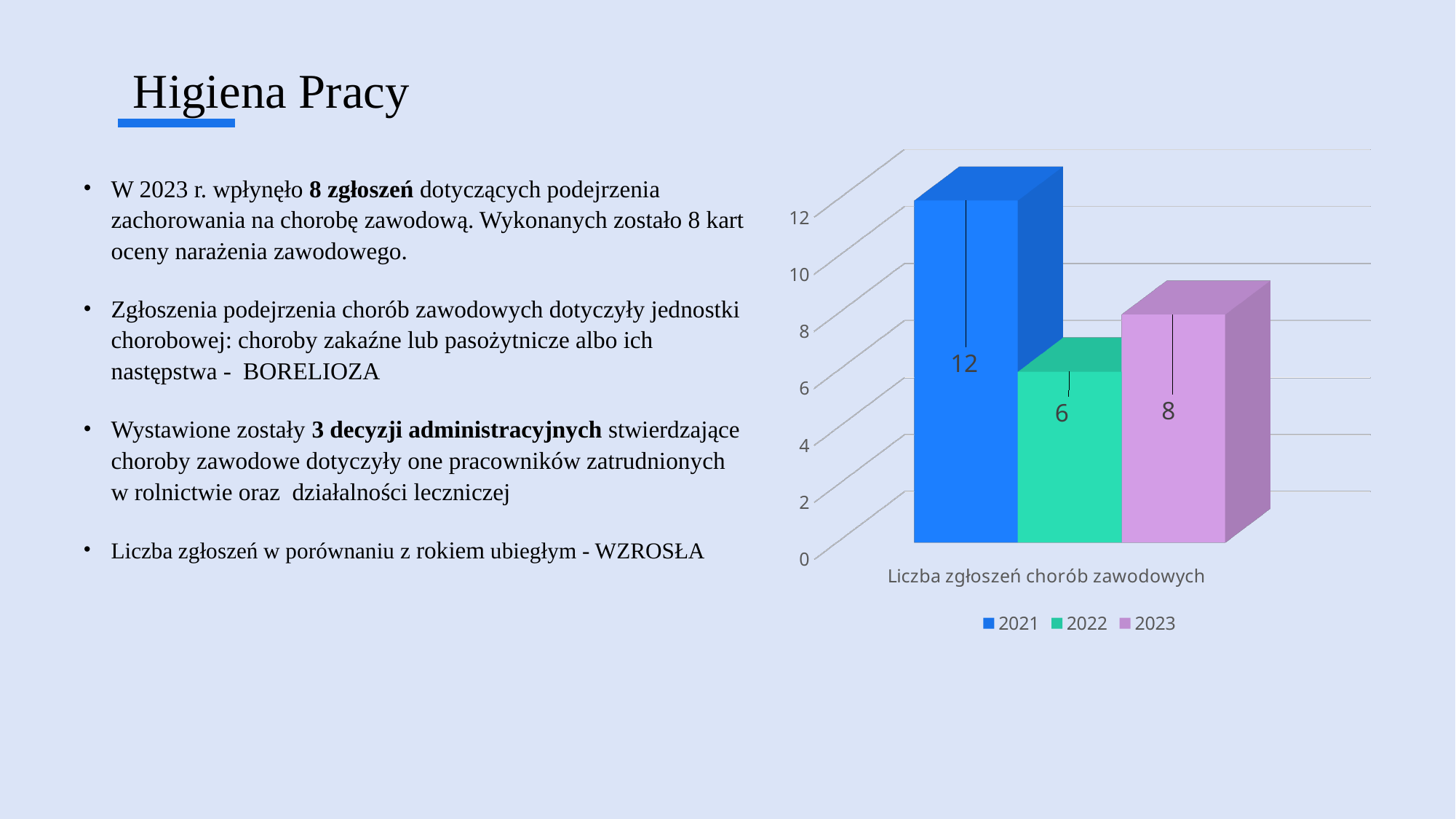
How many series does the legend list? 3 Which year has the highest value in the chart? 2021 What is the value for 2021 in the chart? 12 What kind of chart is shown on the slide? bar chart What is the difference between the values for 2023 and 2022? 2 What is the value for 2023 in the chart? 8 What colour is the bar for 2023? purple What is the difference between the values for 2021 and 2022? 6 What is the category label shown under the bars? Liczba zgłoszeń chorób zawodowych Which is larger, the value for 2022 or the value for 2023? 2023 Which year has the lowest value in the chart? 2022 What is the value for 2022 in the chart? 6